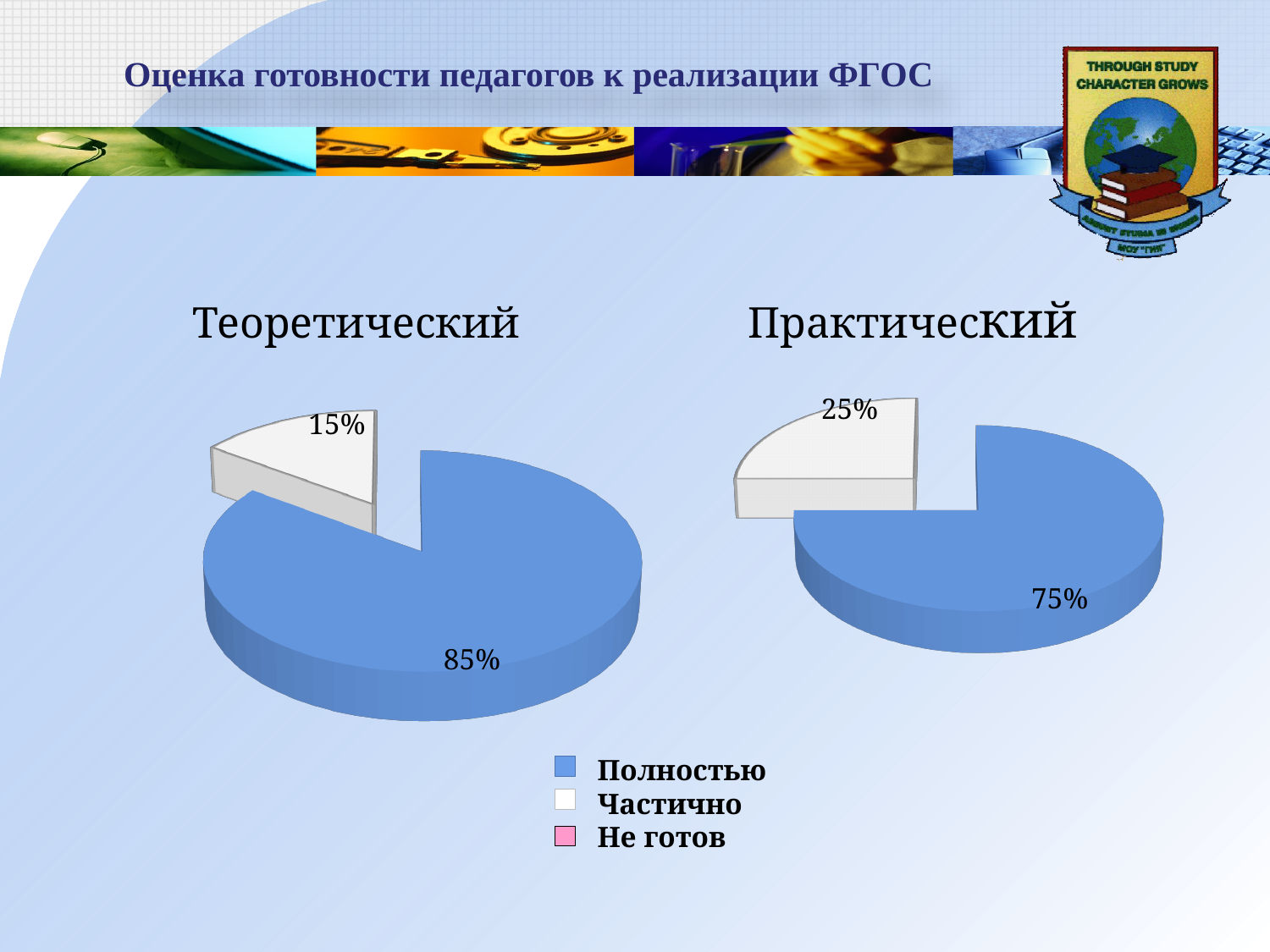
In the "Практический" chart, what share is labelled for the "Частично" slice? 25% In the "Практический" chart, which slice is the smallest among those shown? Частично What kind of chart is used for "Теоретический" and "Практический"? Pie chart Which chart has the larger "Частично" share, "Теоретический" or "Практический"? Практический In the "Теоретический" chart, which slice is the largest? Полностью Which legend entry is shown in blue? Полностью In the "Теоретический" chart, what share is labelled for the "Частично" slice? 15% How many pie charts are shown on the slide? 2 How many entries does the shared legend list? 3 In the "Теоретический" chart, what share is labelled for the "Полностью" slice? 85% In the "Практический" chart, what share is labelled for the "Полностью" slice? 75% What is the difference between the "Полностью" share in the "Теоретический" chart and the "Полностью" share in the "Практический" chart? 10%